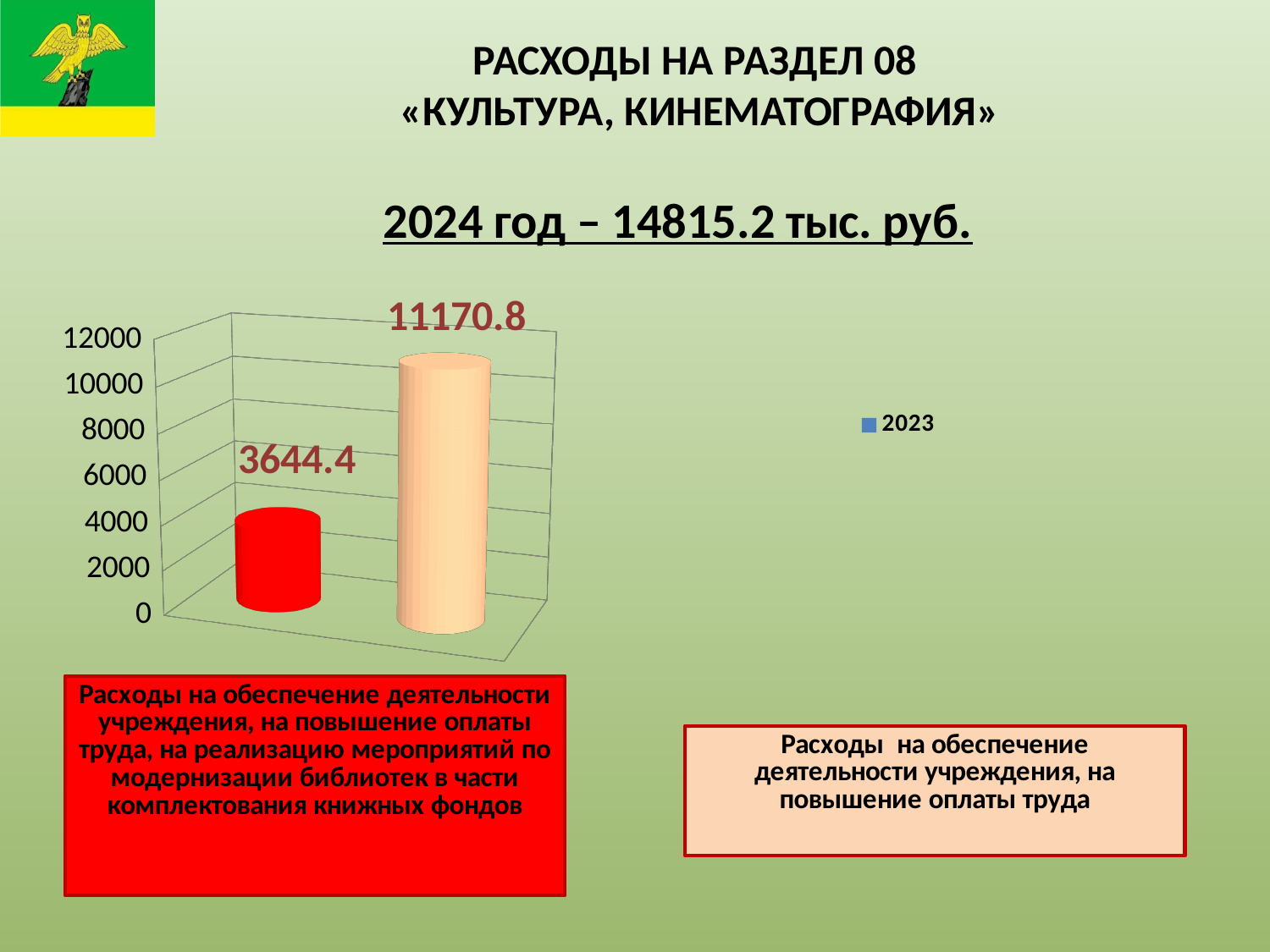
Which bar has the lowest value? the red bar (3644.4) What entry is shown in the chart legend? 2023 What is the sum of the two bar values shown in the chart? 14815.2 How many bars are plotted in the chart? 2 What is the value of the red bar (expenses including modernisation of libraries and acquisition of book collections)? 3644.4 Is the value of the peach-coloured bar greater or less than 10000? greater Which bar has the highest value, the red one or the peach-coloured one? the peach-coloured bar (11170.8) What is the difference between the two bars, 11170.8 and 3644.4? 7526.4 What is the value of the peach-coloured bar (expenses for ensuring the institution's activities and raising wages)? 11170.8 Is the value of the red bar greater or less than 4000? less What type of chart is shown on the slide? bar chart How many series does the legend list? 1